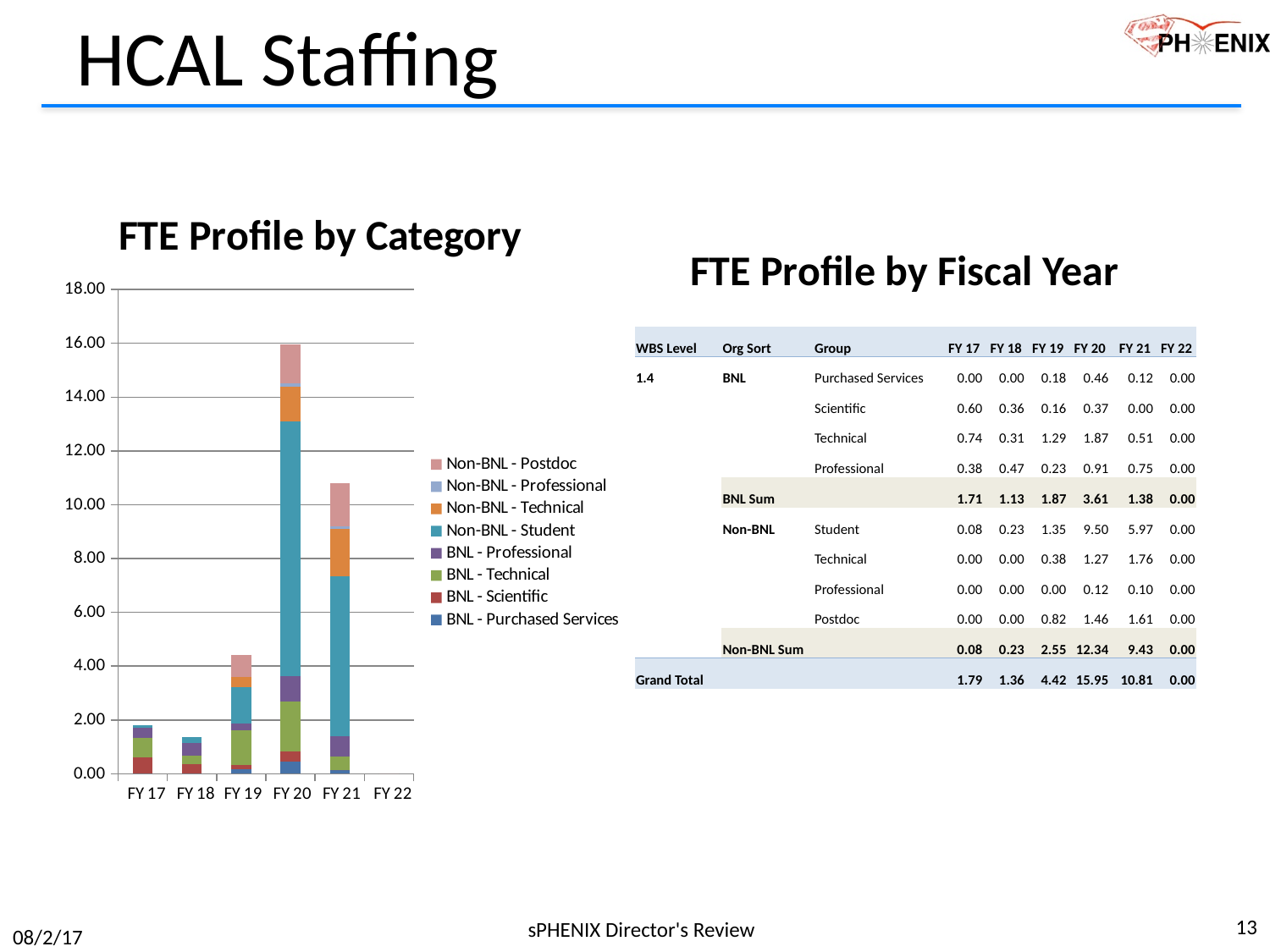
In the "FTE Profile by Category" chart, is the total for FY 19 greater or less than 6.00? less In the "FTE Profile by Category" chart, is the total for FY 20 greater or less than 14.00? greater In the "FTE Profile by Category" chart, which fiscal year has the tallest stacked bar? FY 20 In the "FTE Profile by Category" chart, is the total for FY 17 greater or less than 2.00? less How many series does the legend of the "FTE Profile by Category" chart list? 8 In the "FTE Profile by Category" chart, which series makes up the largest segment of the FY 20 bar? Non-BNL - Student How many fiscal years are shown on the x axis of the "FTE Profile by Category" chart? 6 What kind of chart is the "FTE Profile by Category" chart? Stacked bar chart In the "FTE Profile by Category" chart, which stacked bar is taller, FY 20 or FY 21? FY 20 In the "FTE Profile by Category" chart, which fiscal year has the lowest total (no visible bar)? FY 22 In the "FTE Profile by Category" chart, do the stacked bar totals rise or fall from FY 20 to FY 22? fall According to the slide, what is the grand total FTE for FY 20 (the full height of the FY 20 stacked bar)? 15.95